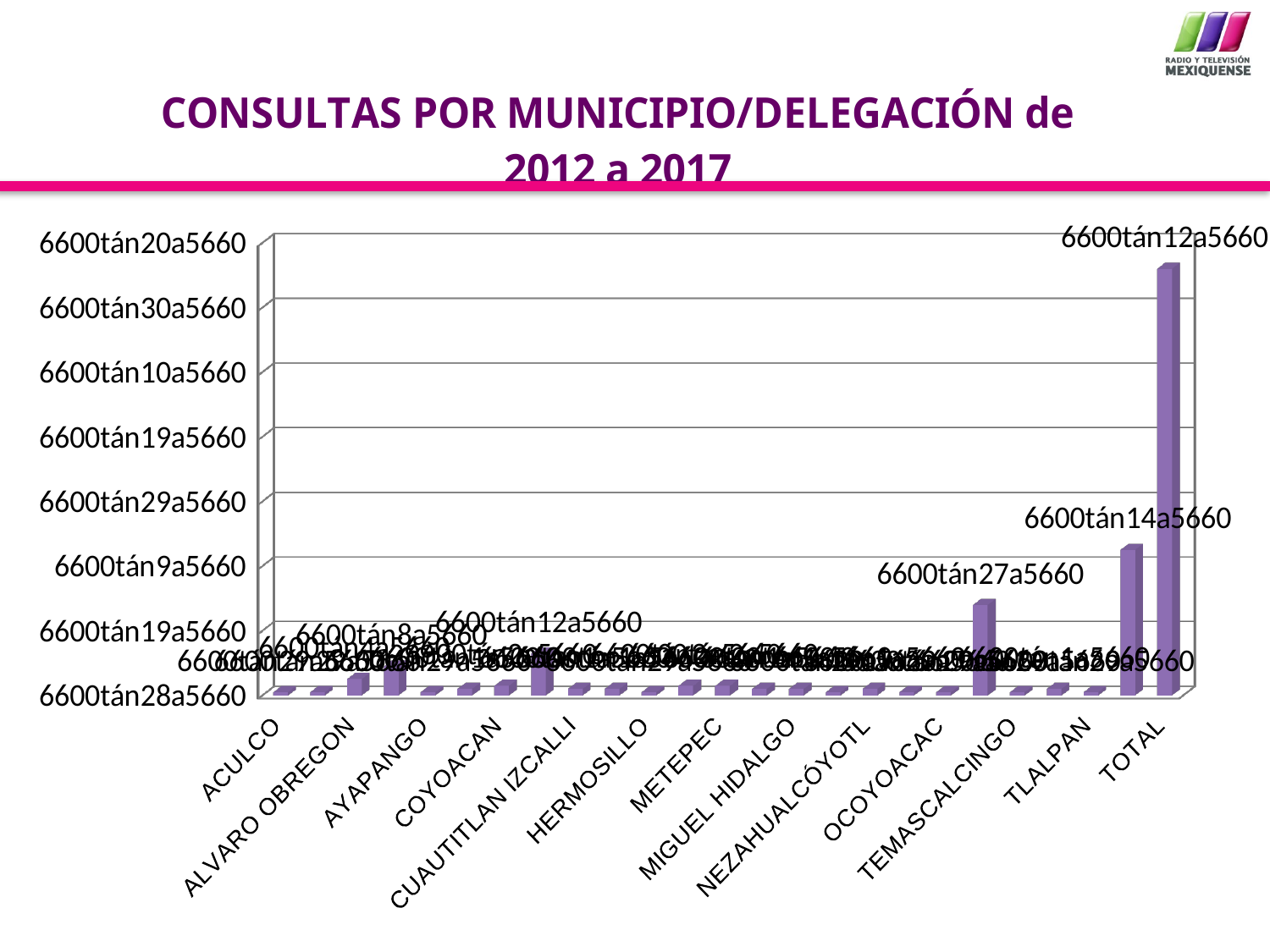
What kind of chart is shown on the slide? bar chart Which has the larger value, TOTAL or TLALPAN? TOTAL What colour are the bars in the chart? purple What is the title of the chart on the slide? CONSULTAS POR MUNICIPIO/DELEGACIÓN de 2012 a 2017 Which category has the tallest bar in the chart? TOTAL